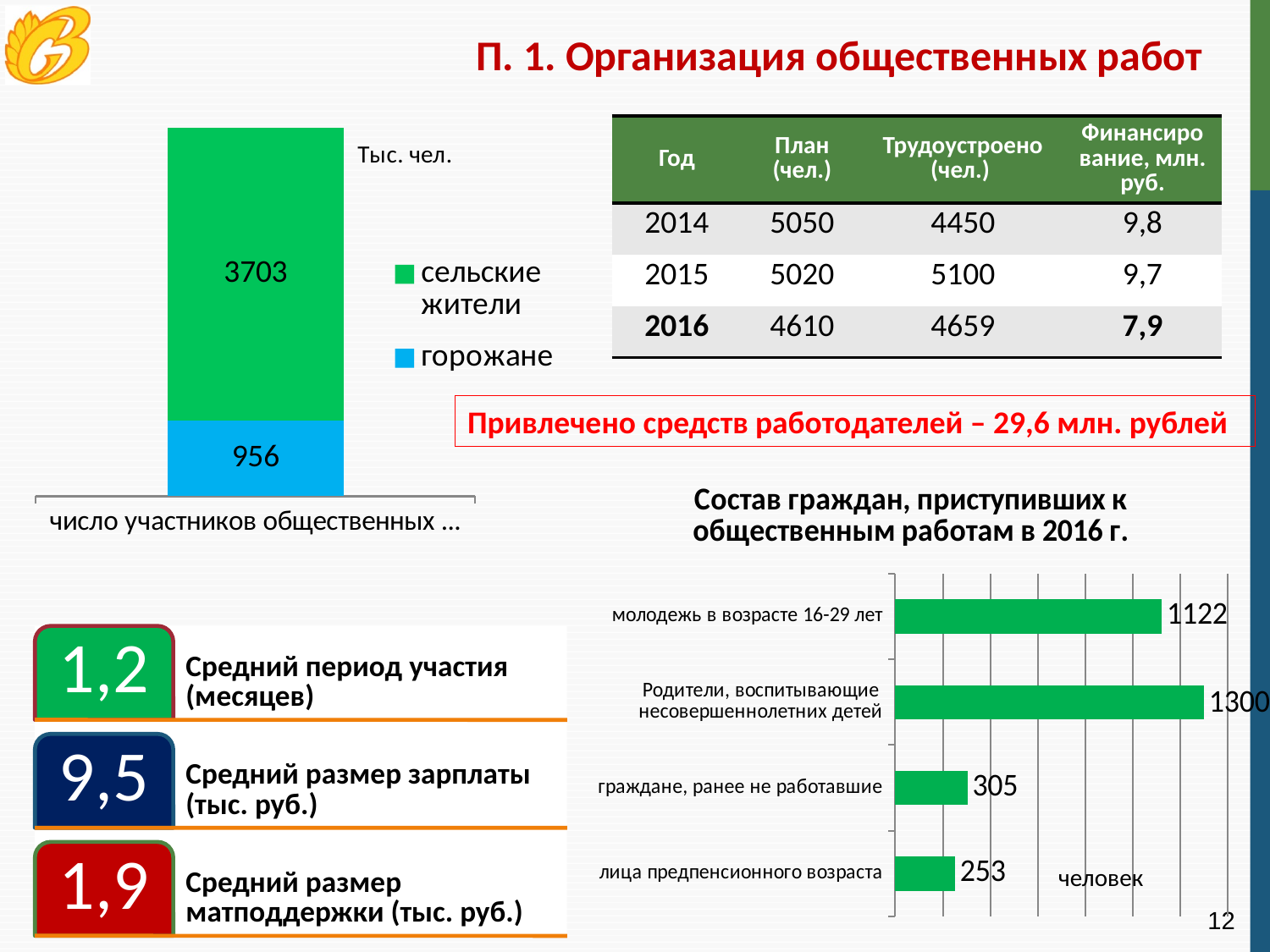
In the stacked bar chart on the left, what is the total of the stacked bar? 4659 In the stacked bar chart on the left, what is the value for горожане? 956 In the stacked bar chart on the left, what is the value for сельские жители? 3703 In the chart 'Состав граждан, приступивших к общественным работам в 2016 г.', how many categories are shown? 4 In the chart 'Состав граждан, приступивших к общественным работам в 2016 г.', which category has the lowest value? лица предпенсионного возраста In the chart 'Состав граждан, приступивших к общественным работам в 2016 г.', what is the value for молодежь в возрасте 16-29 лет? 1122 In the chart 'Состав граждан, приступивших к общественным работам в 2016 г.', which category has the highest value? Родители, воспитывающие несовершеннолетних детей What kind of chart is 'Состав граждан, приступивших к общественным работам в 2016 г.'? bar chart In the chart 'Состав граждан, приступивших к общественным работам в 2016 г.', what is the value for лица предпенсионного возраста? 253 In the chart 'Состав граждан, приступивших к общественным работам в 2016 г.', what is the difference between Родители, воспитывающие несовершеннолетних детей and граждане, ранее не работавшие? 995 In the stacked bar chart on the left, how many series does the legend list? 2 In the stacked bar chart on the left, which series is larger, сельские жители or горожане? сельские жители